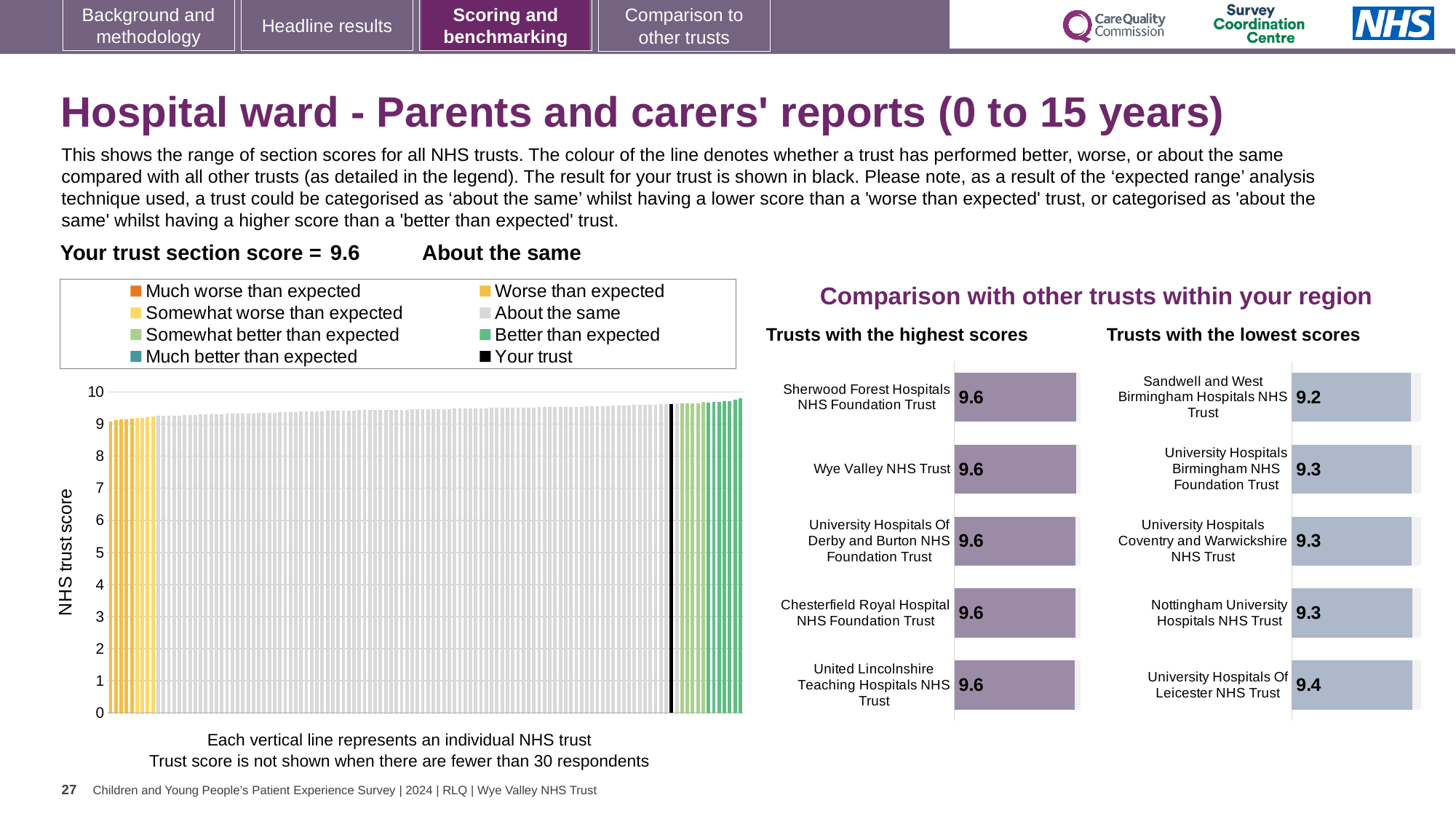
In the 'Trusts with the highest scores' chart, what is the score for Wye Valley NHS Trust? 9.6 In the 'Trusts with the lowest scores' chart, what is the difference between the scores of University Hospitals Of Leicester NHS Trust and Sandwell and West Birmingham Hospitals NHS Trust? 0.2 In the 'Trusts with the lowest scores' chart, which trust has the highest score? University Hospitals Of Leicester NHS Trust What kind of chart is the 'NHS trust score' chart on the left of the slide? Bar chart How many trusts are shown in the 'Trusts with the highest scores' chart? 5 How many entries does the legend of the 'NHS trust score' chart on the left list? 8 In the 'Trusts with the lowest scores' chart, what is the score for Sandwell and West Birmingham Hospitals NHS Trust? 9.2 In the 'Trusts with the lowest scores' chart, which trust has the lowest score? Sandwell and West Birmingham Hospitals NHS Trust In the 'NHS trust score' chart on the left, is the value of the black 'Your trust' bar greater or less than 9? greater In the 'Trusts with the lowest scores' chart, which has the larger score: Nottingham University Hospitals NHS Trust or Sandwell and West Birmingham Hospitals NHS Trust? Nottingham University Hospitals NHS Trust In the 'Trusts with the lowest scores' chart, what is the score for University Hospitals Of Leicester NHS Trust? 9.4 In the 'NHS trust score' chart on the left, do the bar values rise or fall from left to right? Rise